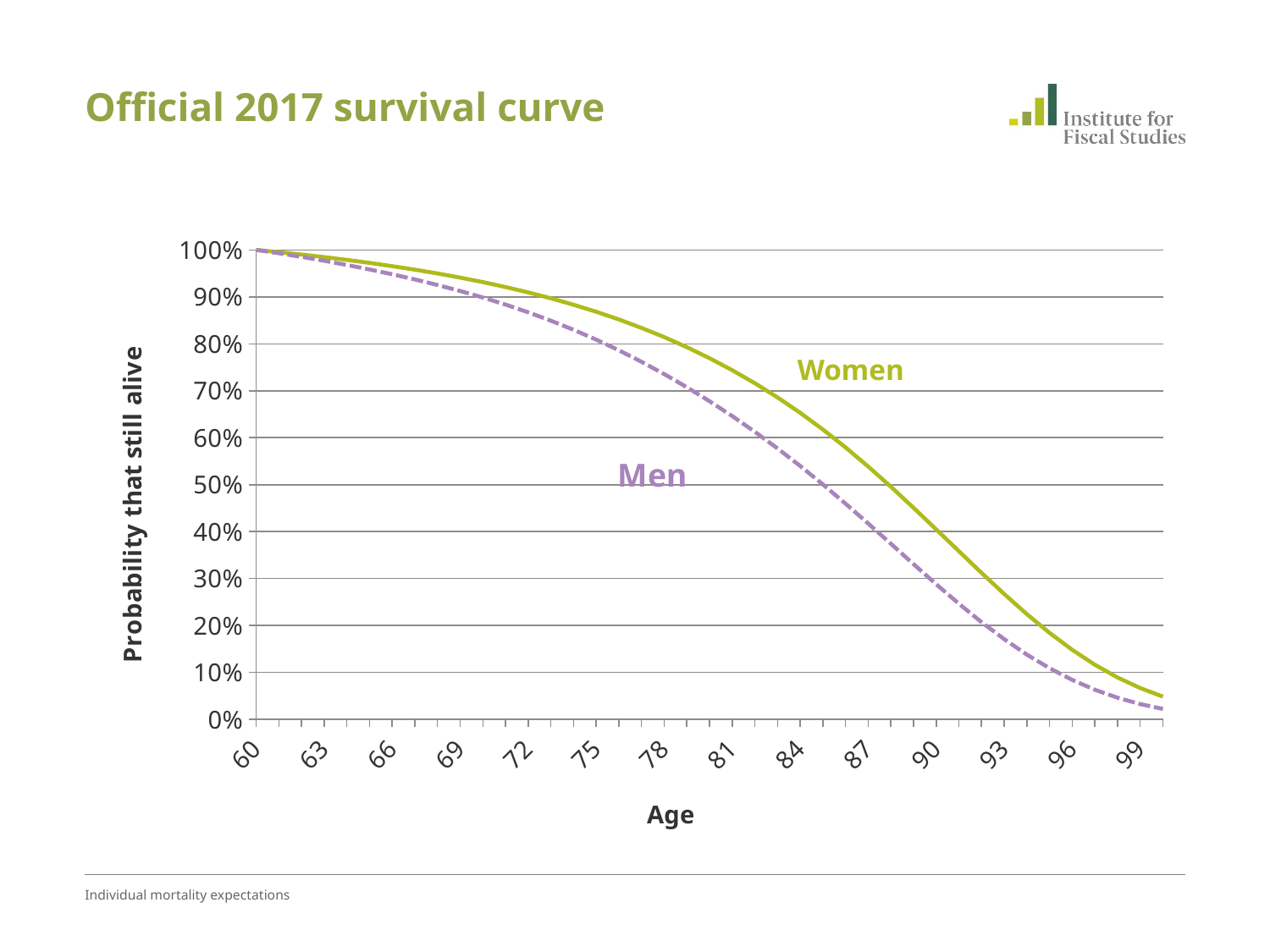
Is the value for Women at age 84 greater or less than 60%? greater Do the survival curves rise or fall as age increases? Fall What is the probability that still alive for Women at age 60? 100% Is the value for Women at age 99 greater or less than 10%? less What kind of chart is shown on the slide? Line chart Is the value for Men at age 84 greater or less than 60%? less What is the title of the chart? Official 2017 survival curve At age 84, which series has the higher probability of still being alive, Women or Men? Women What is the label on the vertical axis? Probability that still alive How many series are plotted on the chart? 2